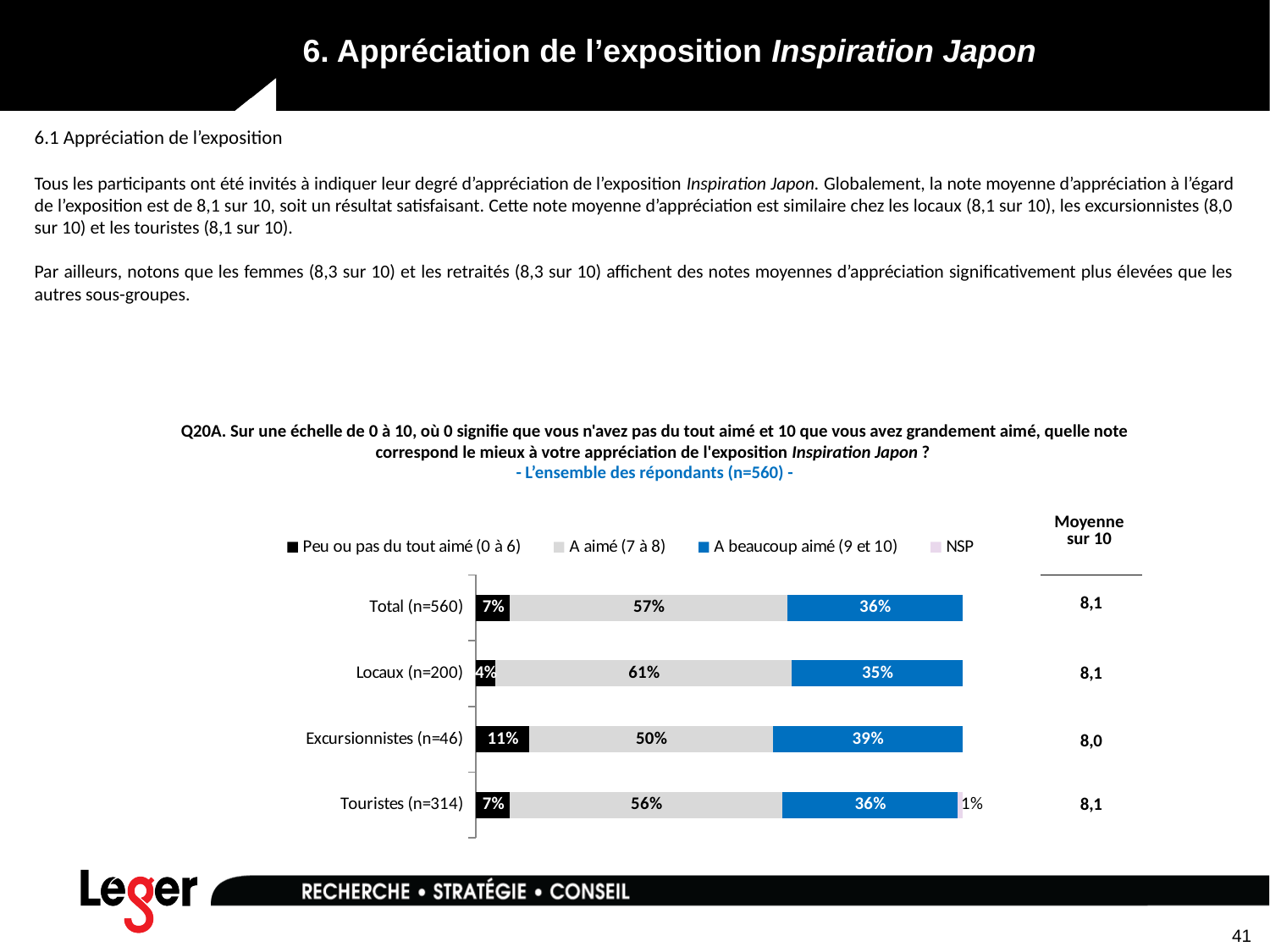
What percentage of Touristes (n=314) answered "NSP"? 1% How many series does the legend list? 4 How many groups (bars) are shown in the chart? 4 What is the "Moyenne sur 10" shown for Excursionnistes (n=46)? 8,0 What percentage of Locaux (n=200) answered "A aimé (7 à 8)"? 61% What percentage of Excursionnistes (n=46) answered "A beaucoup aimé (9 et 10)"? 39% Which legend entry is shown in blue? A beaucoup aimé (9 et 10) Which group has the lowest share of "A aimé (7 à 8)"? Excursionnistes (n=46) Which group has the highest share of "Peu ou pas du tout aimé (0 à 6)"? Excursionnistes (n=46) What kind of chart is shown on the slide? Stacked bar chart What is the difference between the "A aimé (7 à 8)" share for Locaux (n=200) and for Excursionnistes (n=46)? 11 percentage points Which is larger: the "A beaucoup aimé (9 et 10)" share for Excursionnistes (n=46) or for Locaux (n=200)? Excursionnistes (n=46)